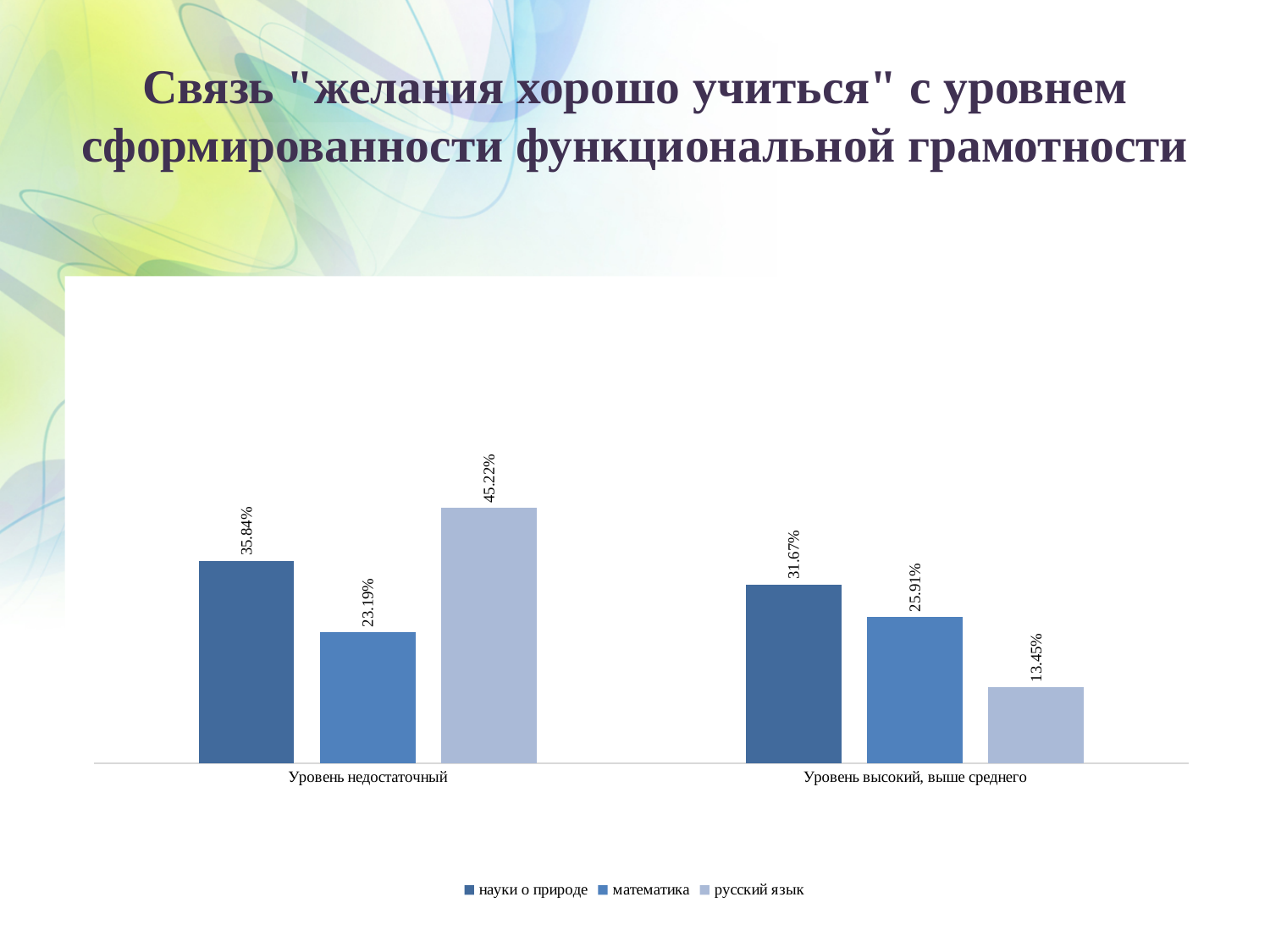
What is the value for науки о природе in the category Уровень недостаточный? 35.84% What type of chart is shown on the slide? bar chart What is the value for математика in the category Уровень высокий, выше среднего? 25.91% How many categories are shown on the x axis? 2 Which series is shown in the lightest blue colour in the legend? русский язык Which series has the lowest value in the category Уровень высокий, выше среднего? русский язык What is the value for русский язык in the category Уровень недостаточный? 45.22% Which is larger: науки о природе for Уровень недостаточный or науки о природе for Уровень высокий, выше среднего? Уровень недостаточный Which series has the highest value in the category Уровень недостаточный? русский язык How many series does the legend list? 3 What is the difference between the русский язык values for Уровень недостаточный and Уровень высокий, выше среднего? 31.77% What is the difference between науки о природе and математика in the category Уровень недостаточный? 12.65%